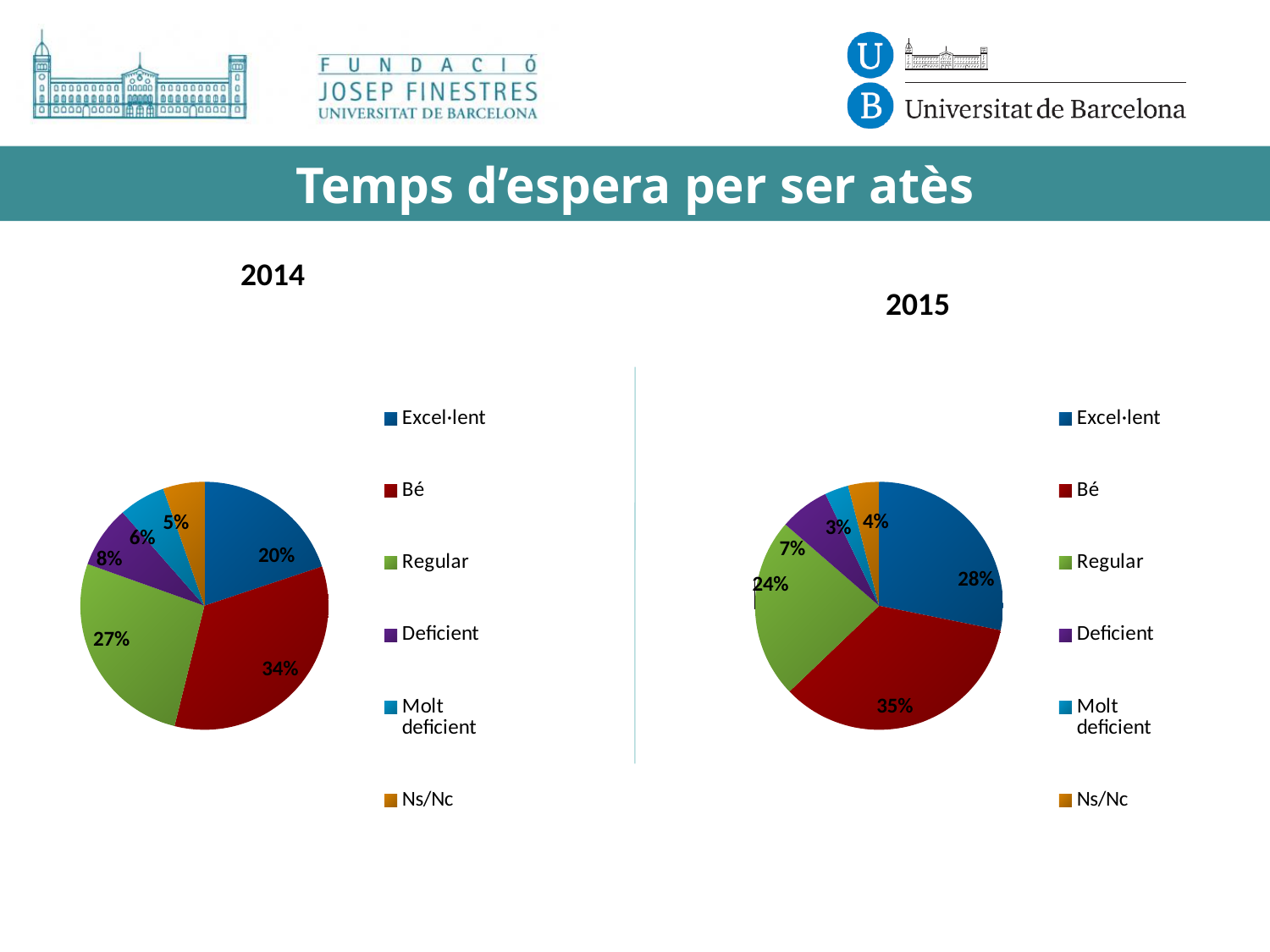
In the 2015 pie chart, which is larger, Regular or Excel·lent? Excel·lent In the 2014 pie chart, which category has the largest slice? Bé What kind of chart is the 2014 chart? Pie chart In the 2014 pie chart, what is the difference between the Bé and Excel·lent shares? 14% In the 2015 pie chart, which category has the smallest slice? Molt deficient In the 2014 pie chart, what share does Bé have? 34% In the 2014 pie chart, what share does Ns/Nc have? 5% In the 2015 pie chart, which colour represents Bé? Red In the 2014 pie chart, what share does Regular have? 27% How many categories does the legend of the 2015 pie chart list? 6 In the 2015 pie chart, what share does Excel·lent have? 28% In the 2015 pie chart, what share does Deficient have? 7%